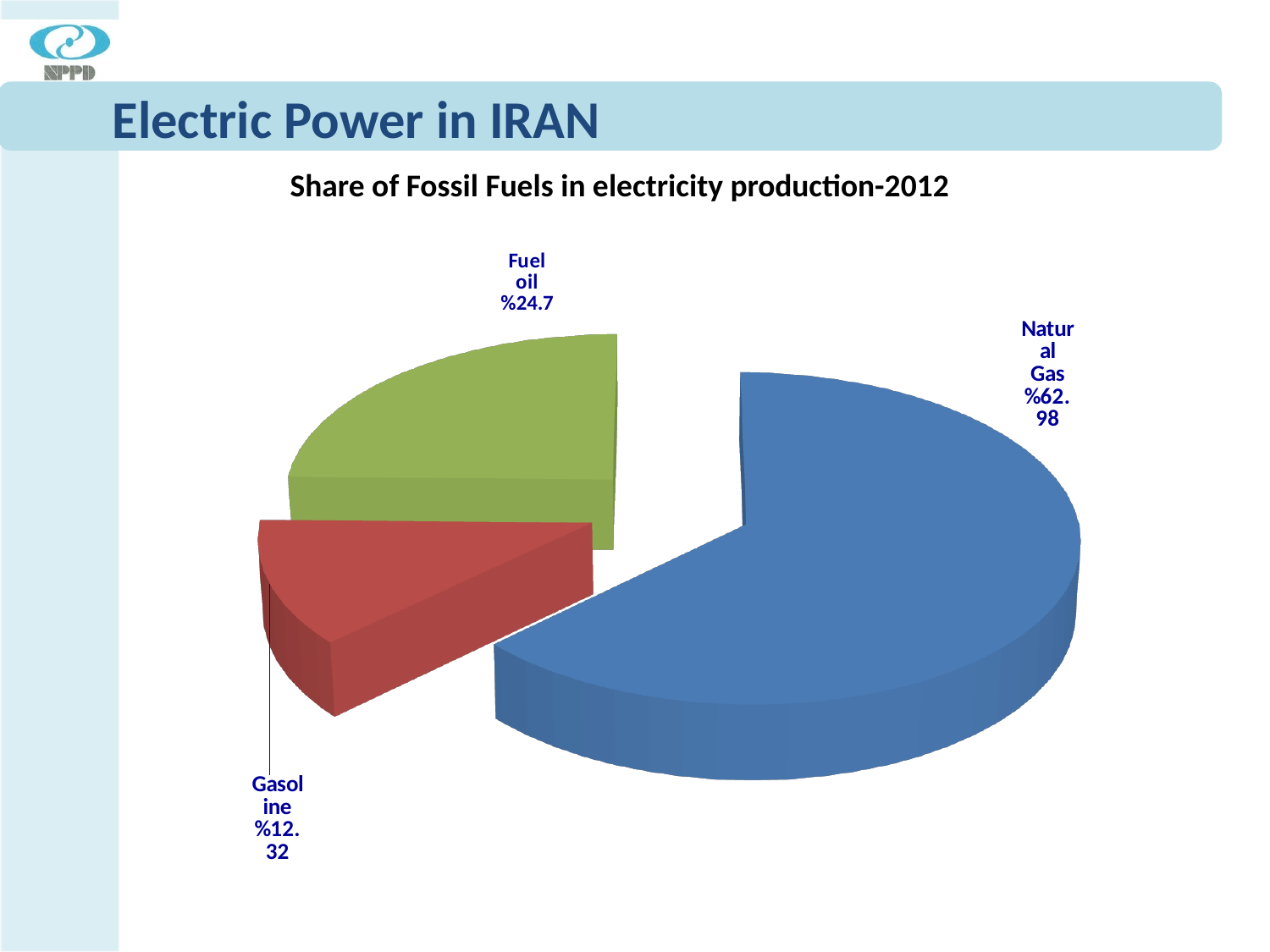
What is the share of Fuel oil in the pie chart? %24.7 What is the title of the chart? Share of Fossil Fuels in electricity production-2012 What kind of chart is shown on the slide? pie chart What is the difference in percentage points between the Fuel oil share and the Gasoline share? 12.38 Which colour is used for the Natural Gas slice? blue How many slices does the pie chart have? 3 What is the share of Gasoline in the pie chart? %12.32 What is the difference in percentage points between the Natural Gas share and the Fuel oil share? 38.28 Which fuel has the largest share of electricity production? Natural Gas Which fuel has the smallest share of electricity production? Gasoline Which has a larger share, Fuel oil or Gasoline? Fuel oil What is the share of Natural Gas in the pie chart? %62.98